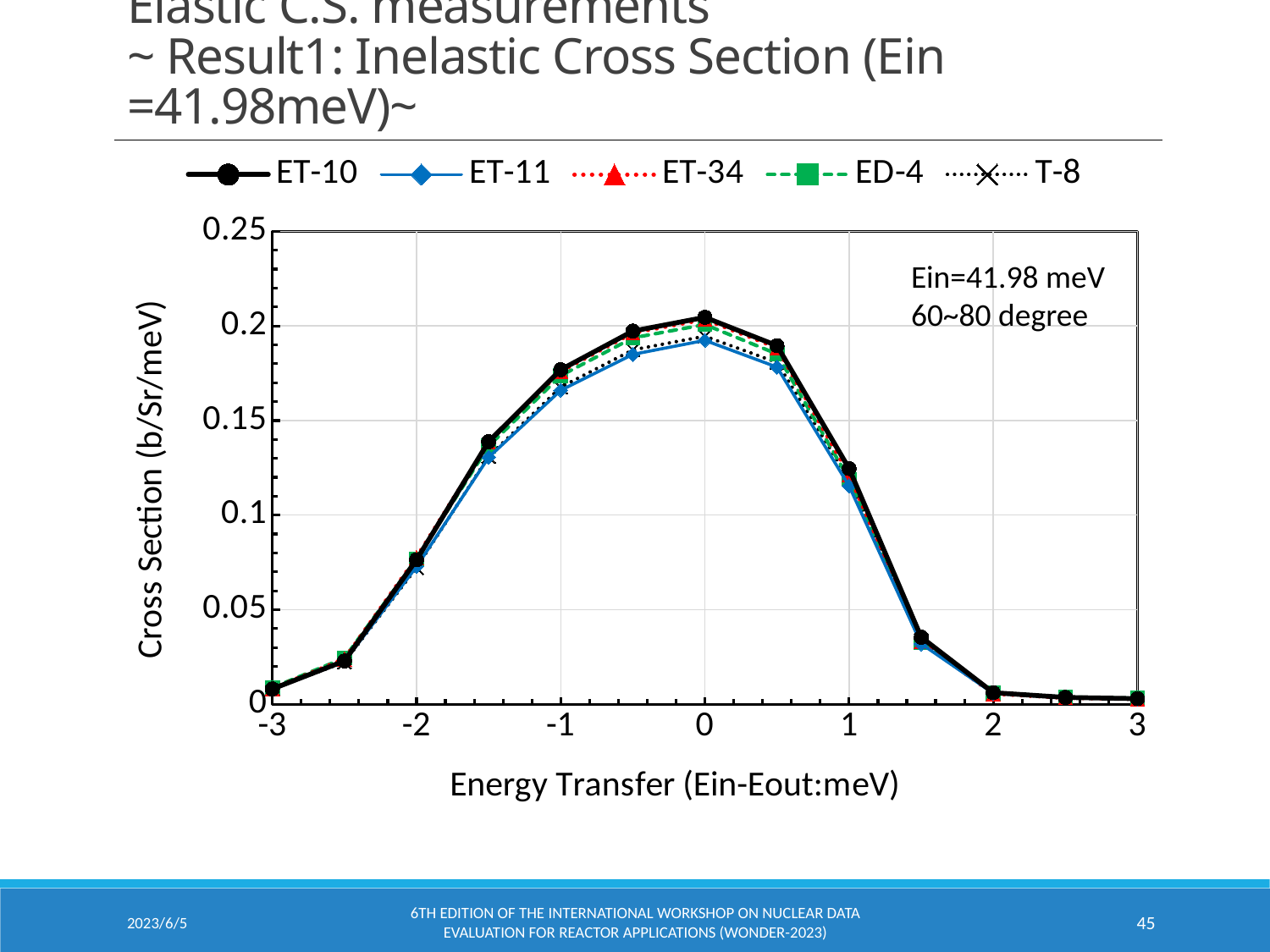
Do the cross section values rise or fall as Energy Transfer goes from -3 to 0? rise Is the ET-10 value at Energy Transfer 2 greater or less than 0.05? less What kind of chart is shown on the slide? line chart Is the ET-10 value at Energy Transfer 0 greater or less than 0.2? greater At which Energy Transfer value does the ET-10 series reach its highest cross section? 0 At Energy Transfer 0, which series has the larger cross section, ET-10 or ET-11? ET-10 Is the ET-11 value at Energy Transfer 0 greater or less than 0.2? less What is the title of the y axis? Cross Section (b/Sr/meV) What angular range is stated in the annotation inside the chart? 60~80 degree How many series does the legend list? 5